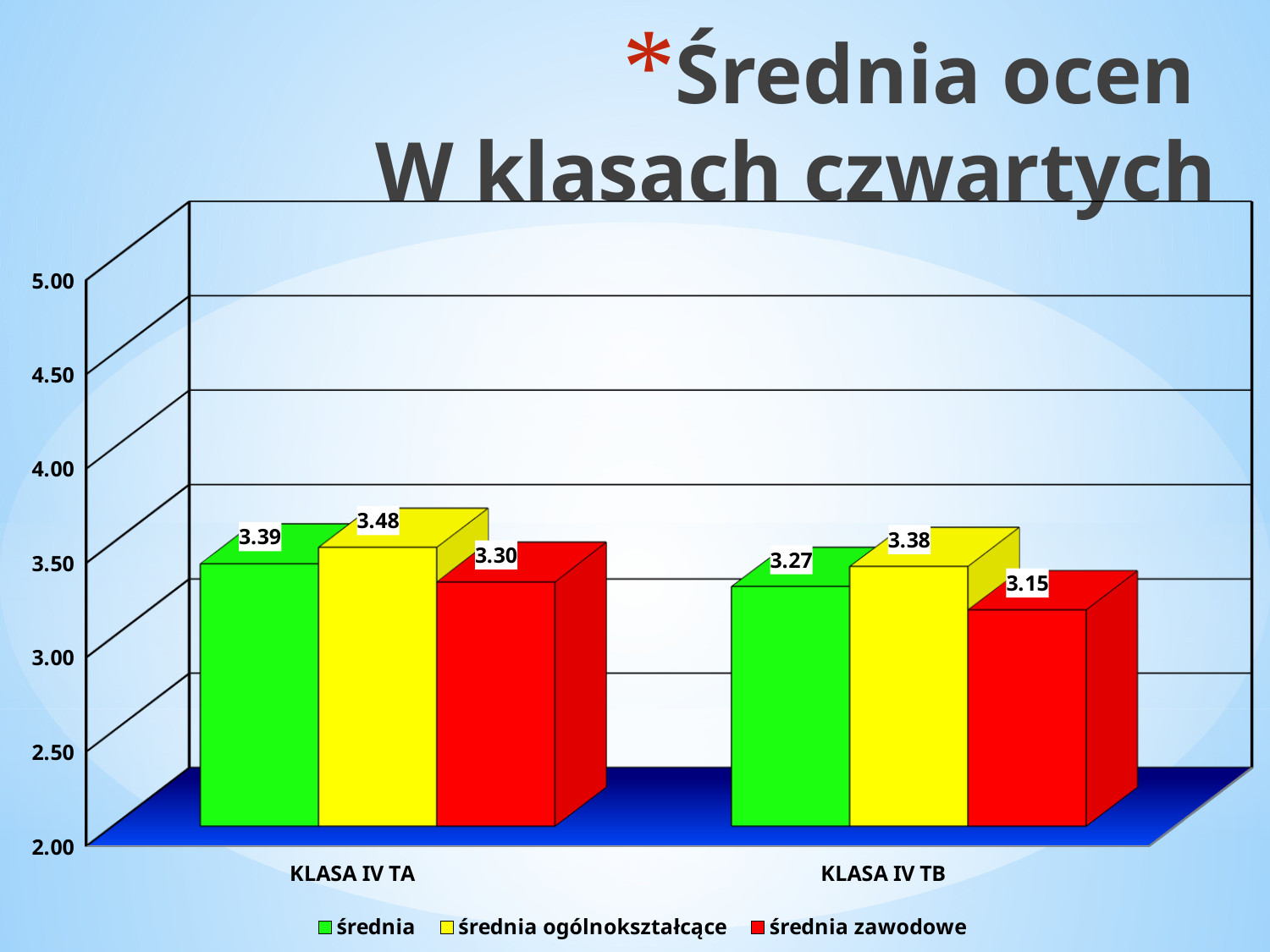
What is the value of 'średnia zawodowe' for KLASA IV TB? 3.15 What kind of chart is shown on the slide? bar chart What is the value of 'średnia ogólnokształcące' for KLASA IV TB? 3.38 How many series does the legend list? 3 What is the value of 'średnia' for KLASA IV TA? 3.39 What is the value of 'średnia zawodowe' for KLASA IV TA? 3.30 What is the difference in 'średnia' between KLASA IV TA and KLASA IV TB? 0.12 Which series has the lowest value for KLASA IV TB? średnia zawodowe Which series has the highest value for KLASA IV TA? średnia ogólnokształcące Which class has the larger 'średnia zawodowe' value, KLASA IV TA or KLASA IV TB? KLASA IV TA What is the difference between 'średnia ogólnokształcące' and 'średnia zawodowe' for KLASA IV TB? 0.23 How many categories are shown on the x axis? 2